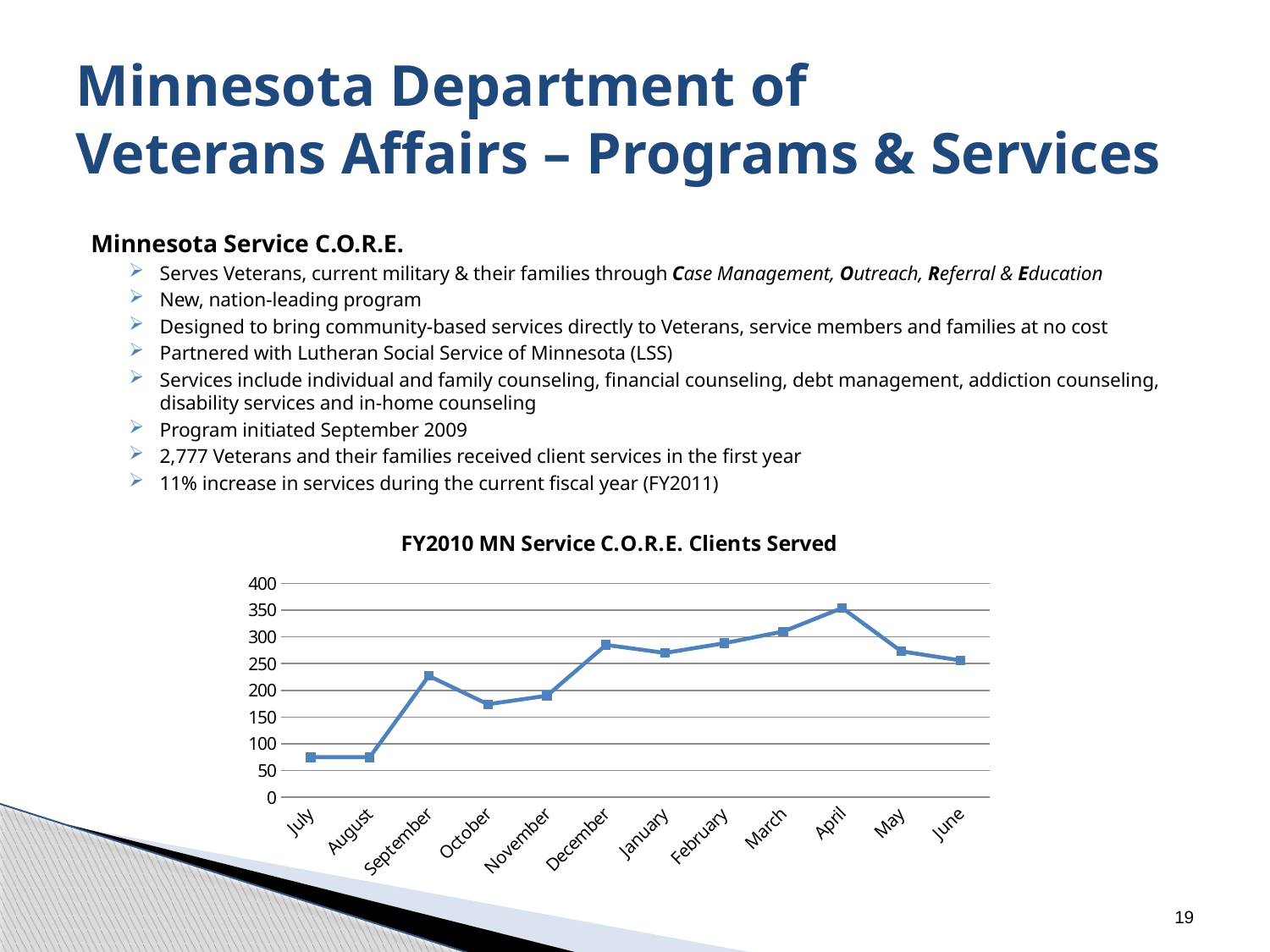
How many months are plotted on the x axis of the chart? 12 Which month has the larger value, April or May? April Which month has the highest number of clients served? April Is the value for December greater or less than 250? greater Do the values generally rise or fall from July to April? rise Which month has the larger value, September or October? September What is the title of the chart? FY2010 MN Service C.O.R.E. Clients Served Is the value for September greater or less than 200? greater Is the value for April greater or less than 300? greater What kind of chart is shown on the slide? line chart